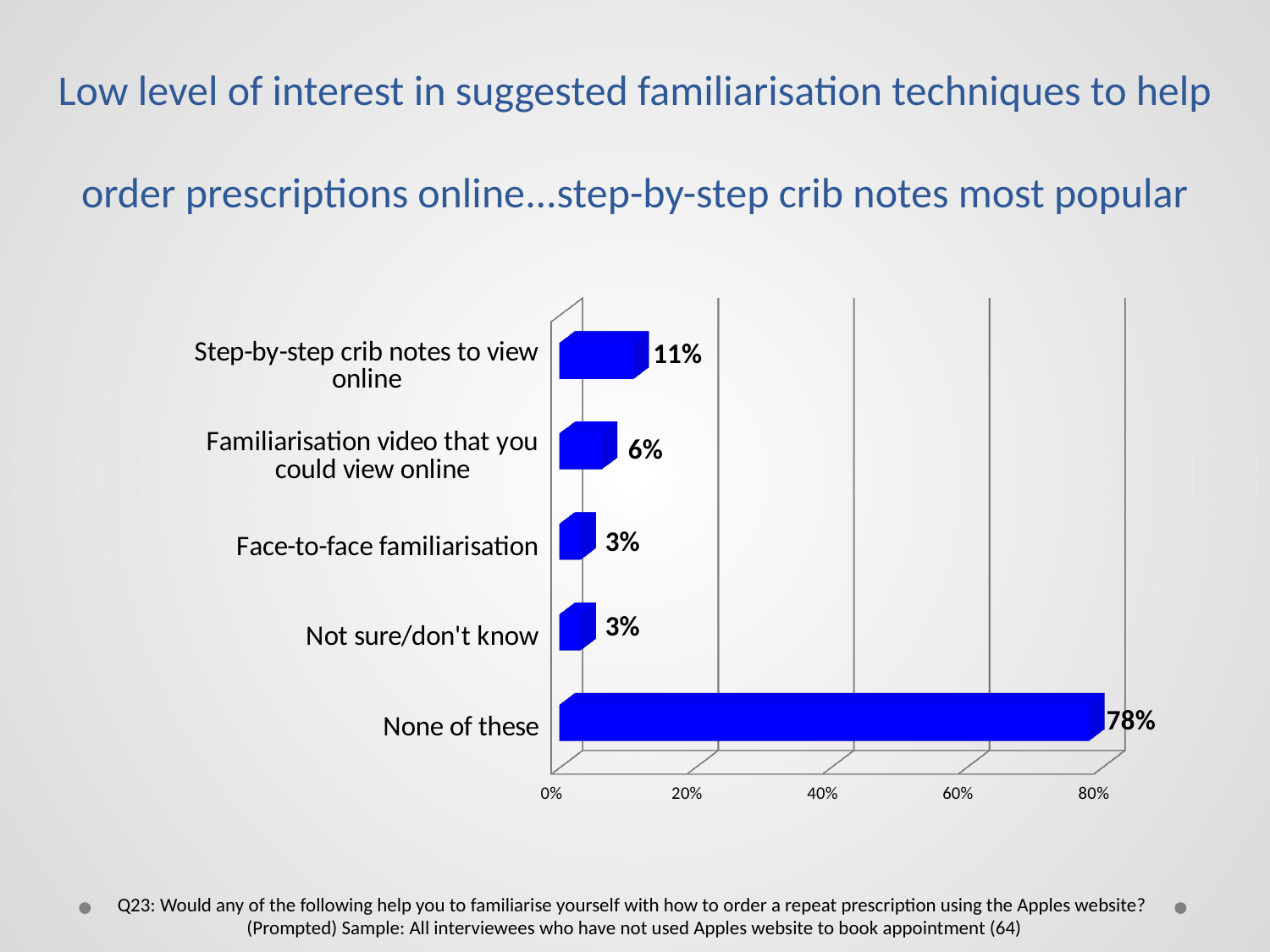
Is the value for "None of these" greater or less than 60%? greater What is the value for "Step-by-step crib notes to view online"? 11% What is the difference between the values for "None of these" and "Step-by-step crib notes to view online"? 67% What is the value for "Face-to-face familiarisation"? 3% What is the difference between the values for "Familiarisation video that you could view online" and "Not sure/don't know"? 3% Which category has the highest value? None of these What kind of chart is shown on the slide? Bar chart What is the value for "Familiarisation video that you could view online"? 6% How many categories are shown in the chart? 5 Which is larger, the value for "Step-by-step crib notes to view online" or "Familiarisation video that you could view online"? Step-by-step crib notes to view online What colour are the bars in the chart? Blue What is the value for "None of these"? 78%